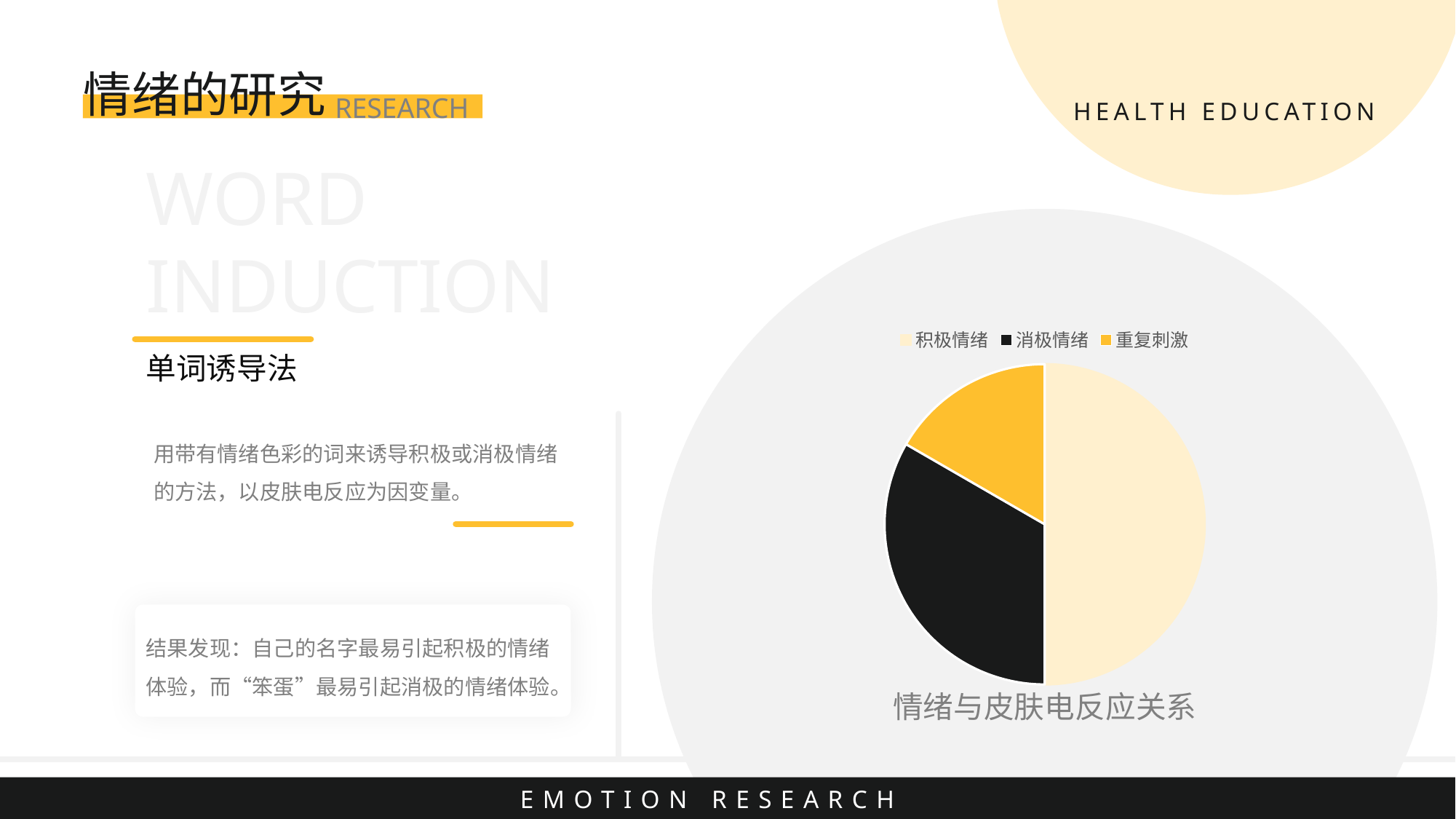
Which slice is larger in the pie chart, 消极情绪 or 重复刺激? 消极情绪 How many slices does the pie chart have? 3 What is the title of the pie chart? 情绪与皮肤电反应关系 Which category has the largest slice in the pie chart? 积极情绪 Which category is shown in black in the pie chart? 消极情绪 What kind of chart is shown on the slide? pie chart Which slice is larger in the pie chart, 积极情绪 or 消极情绪? 积极情绪 How many entries does the legend of the pie chart list? 3 Which category has the smallest slice in the pie chart? 重复刺激